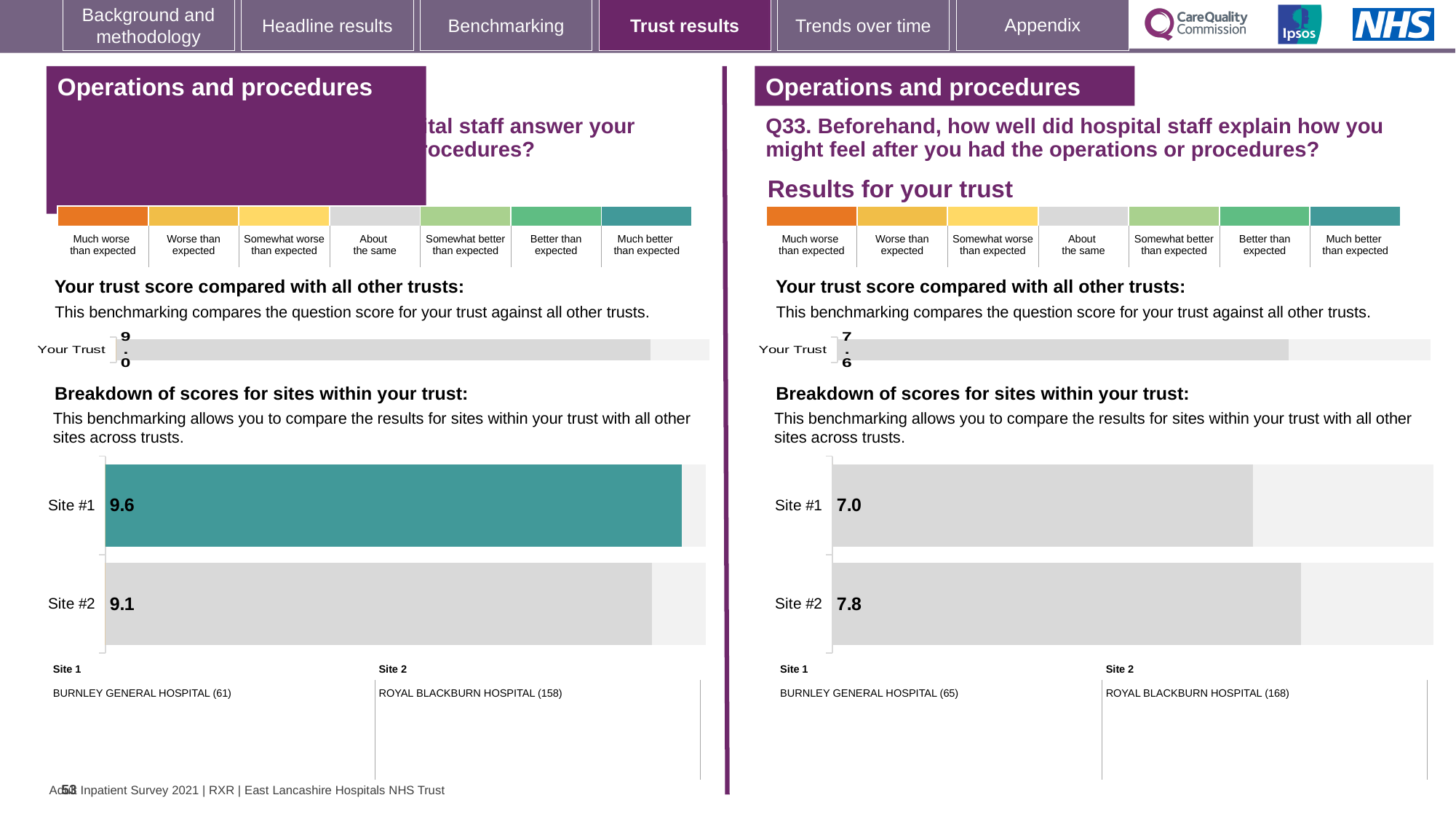
What type of chart is the left-hand site breakdown chart? Bar chart On the left-hand 'Your trust score compared with all other trusts' chart, what is the score for Your Trust? 9.0 On the right-hand Q33 site breakdown chart, which site has the lower score? Site #1 On the right-hand Q33 'Breakdown of scores for sites within your trust' chart, what is the score for Site #1? 7.0 On the left-hand 'Breakdown of scores for sites within your trust' chart, what is the score for Site #2? 9.1 On the left-hand site breakdown chart, which site has the higher score? Site #1 On the right-hand Q33 'Breakdown of scores for sites within your trust' chart, what is the score for Site #2? 7.8 How many sites are shown on the right-hand Q33 site breakdown chart? 2 On the left-hand site breakdown chart, what is the difference between the Site #1 and Site #2 scores? 0.5 On the right-hand Q33 'Your trust score compared with all other trusts' chart, what is the score for Your Trust? 7.6 On the left-hand 'Breakdown of scores for sites within your trust' chart, what is the score for Site #1? 9.6 On the right-hand Q33 site breakdown chart, what is the difference between the Site #2 and Site #1 scores? 0.8